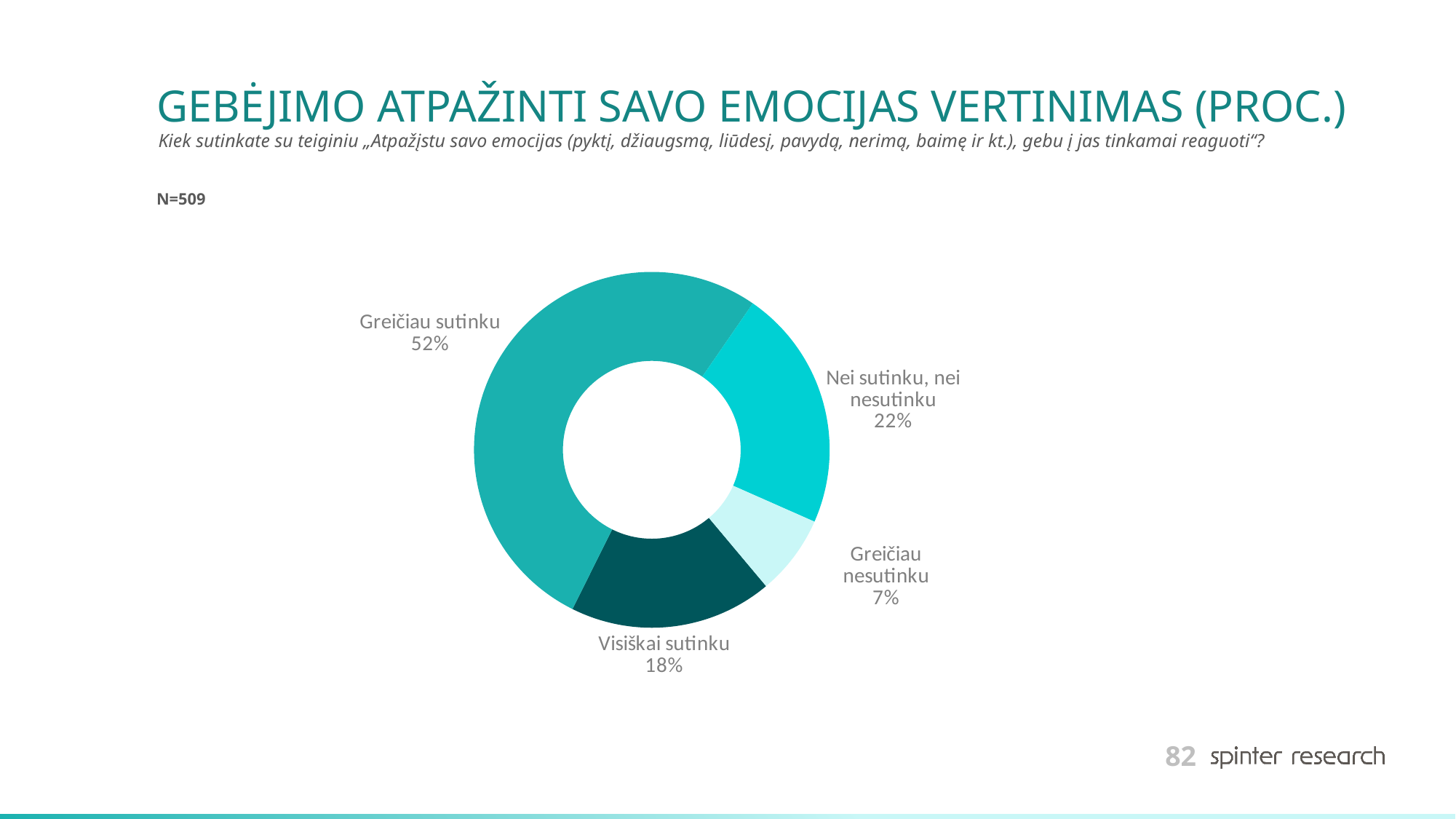
What percentage of respondents answered "Greičiau sutinku"? 52% What is the difference in percentage points between "Greičiau sutinku" and "Visiškai sutinku"? 34 What is the sample size (N) stated on the slide? N=509 What is the combined share of "Greičiau sutinku" and "Visiškai sutinku"? 70% Which response category has the smallest share of the chart? Greičiau nesutinku How many response categories are shown in the chart? 4 What percentage of respondents answered "Greičiau nesutinku"? 7% Which is larger: the share for "Nei sutinku, nei nesutinku" or the share for "Visiškai sutinku"? Nei sutinku, nei nesutinku What percentage of respondents answered "Nei sutinku, nei nesutinku"? 22% What type of chart is shown on the slide? Doughnut (pie) chart What percentage of respondents answered "Visiškai sutinku"? 18% Which response category has the largest share of the chart? Greičiau sutinku